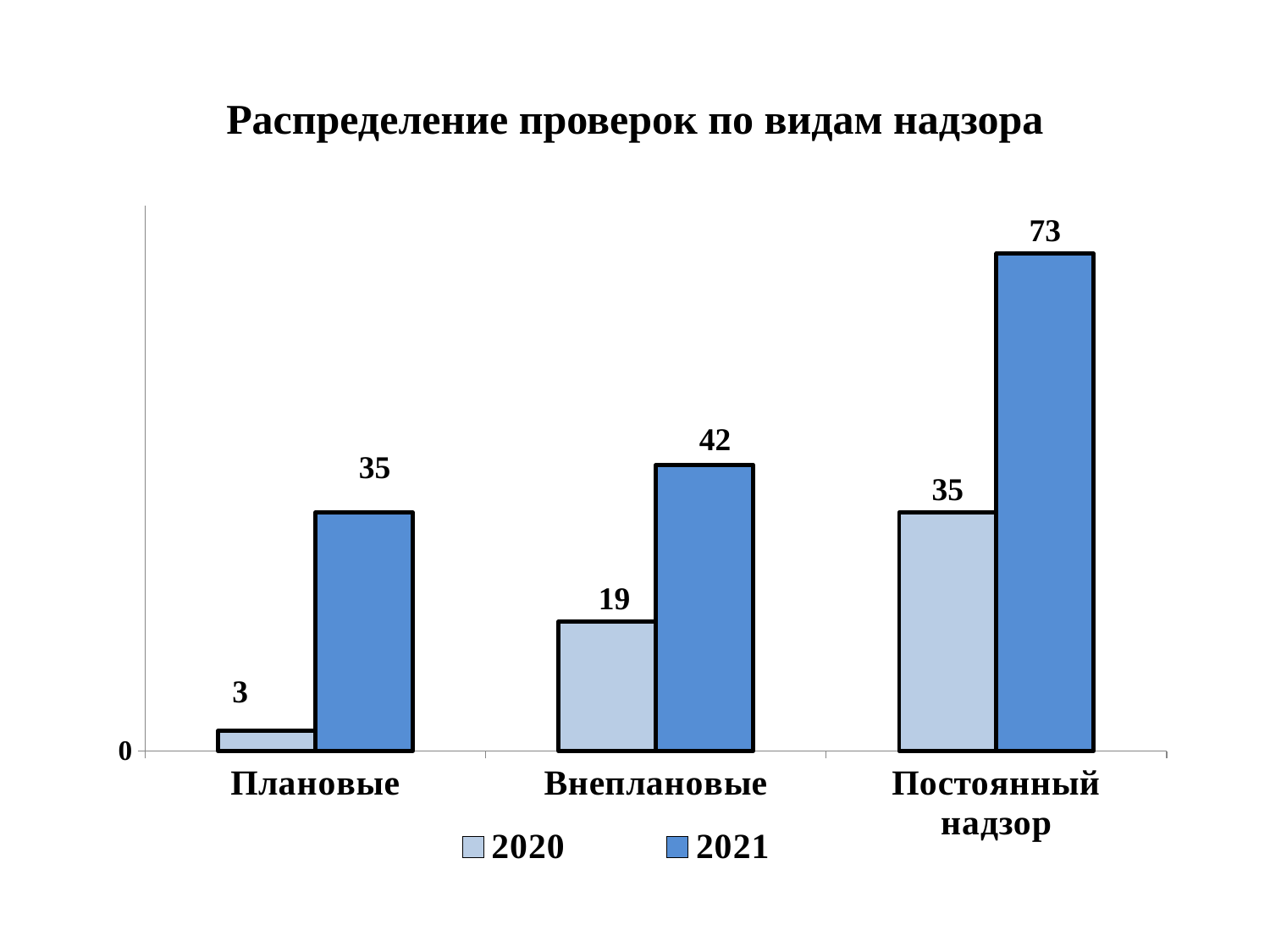
What is the difference between the 2021 and 2020 values for Внеплановые? 23 Which category has the highest value in 2021? Постоянный надзор What is the title of the chart? Распределение проверок по видам надзора What is the value for Плановые in 2020? 3 How many series does the legend list? 2 Which category has the lowest value in 2020? Плановые What is the difference between the 2021 and 2020 values for Постоянный надзор? 38 What kind of chart is shown on the slide? Bar chart What is the value for Внеплановые in 2021? 42 Which is larger: the 2020 value for Постоянный надзор or the 2021 value for Плановые? They are equal (35) What is the value for Постоянный надзор in 2021? 73 How many categories are shown on the x axis? 3